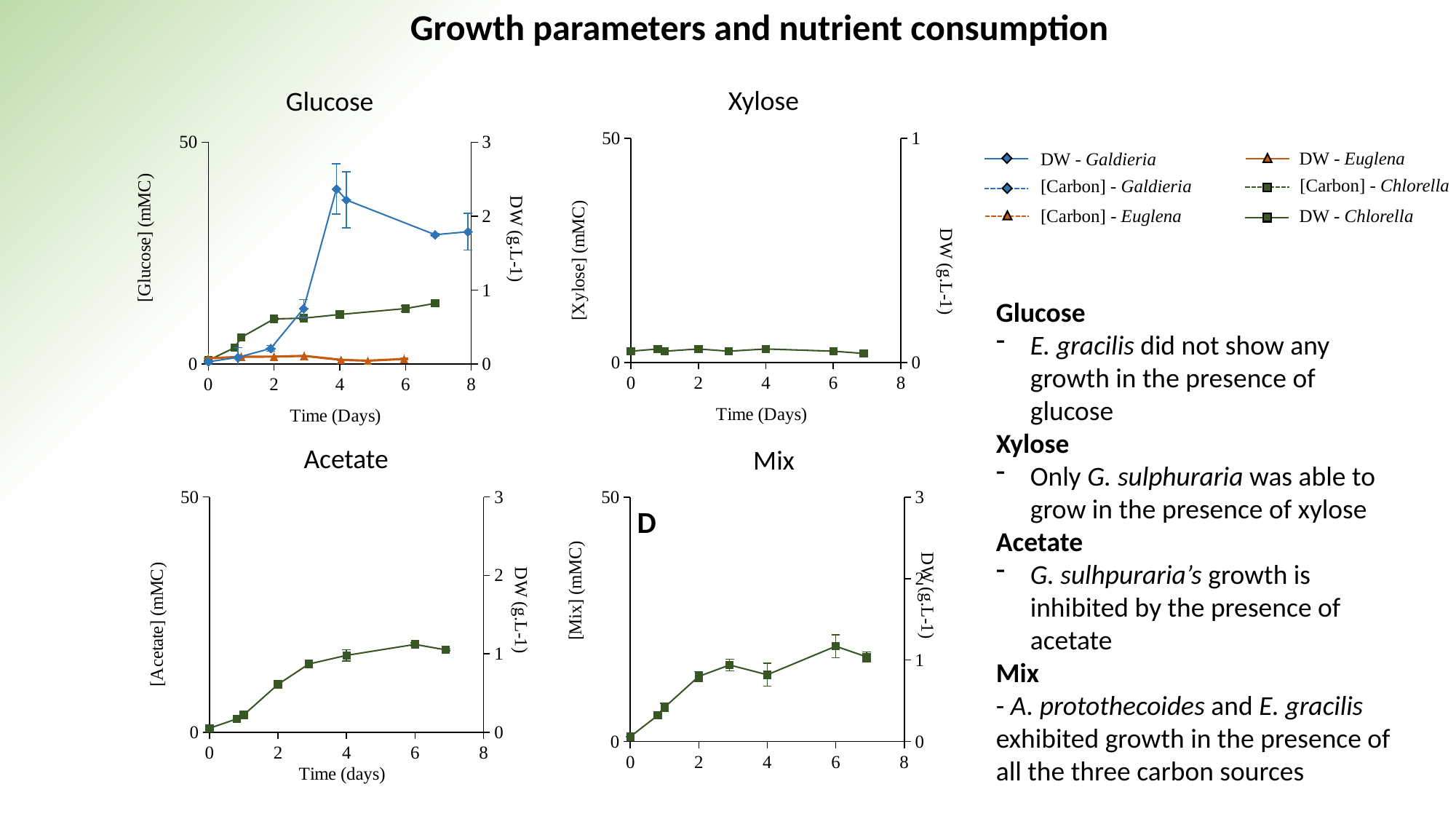
In the Glucose chart, which DW series stays lowest across the whole time course? DW - Euglena In the Acetate chart, is the DW value at day 2 greater or less than 1 g.L-1? less What is the label of the left-hand y axis of the Acetate chart? [Acetate] (mMC) In the Glucose chart, which series reaches the highest dry weight (DW)? DW - Galdieria In the Acetate chart, does the DW value generally rise or fall from day 0 to day 6? rise What is the maximum value shown on the right-hand (DW) axis of the Xylose chart? 1 In the Glucose chart, is the DW - Galdieria value at day 4 greater or less than 2 g.L-1? greater What kind of chart is the Glucose chart? line chart In the Acetate chart, which is larger: the DW value at day 6 or at day 2? day 6 In the Glucose chart, at day 4, which is larger: DW - Galdieria or DW - Chlorella? DW - Galdieria How many series does the legend list? 6 In the Mix chart, is the DW value at day 1 greater or less than 1 g.L-1? less